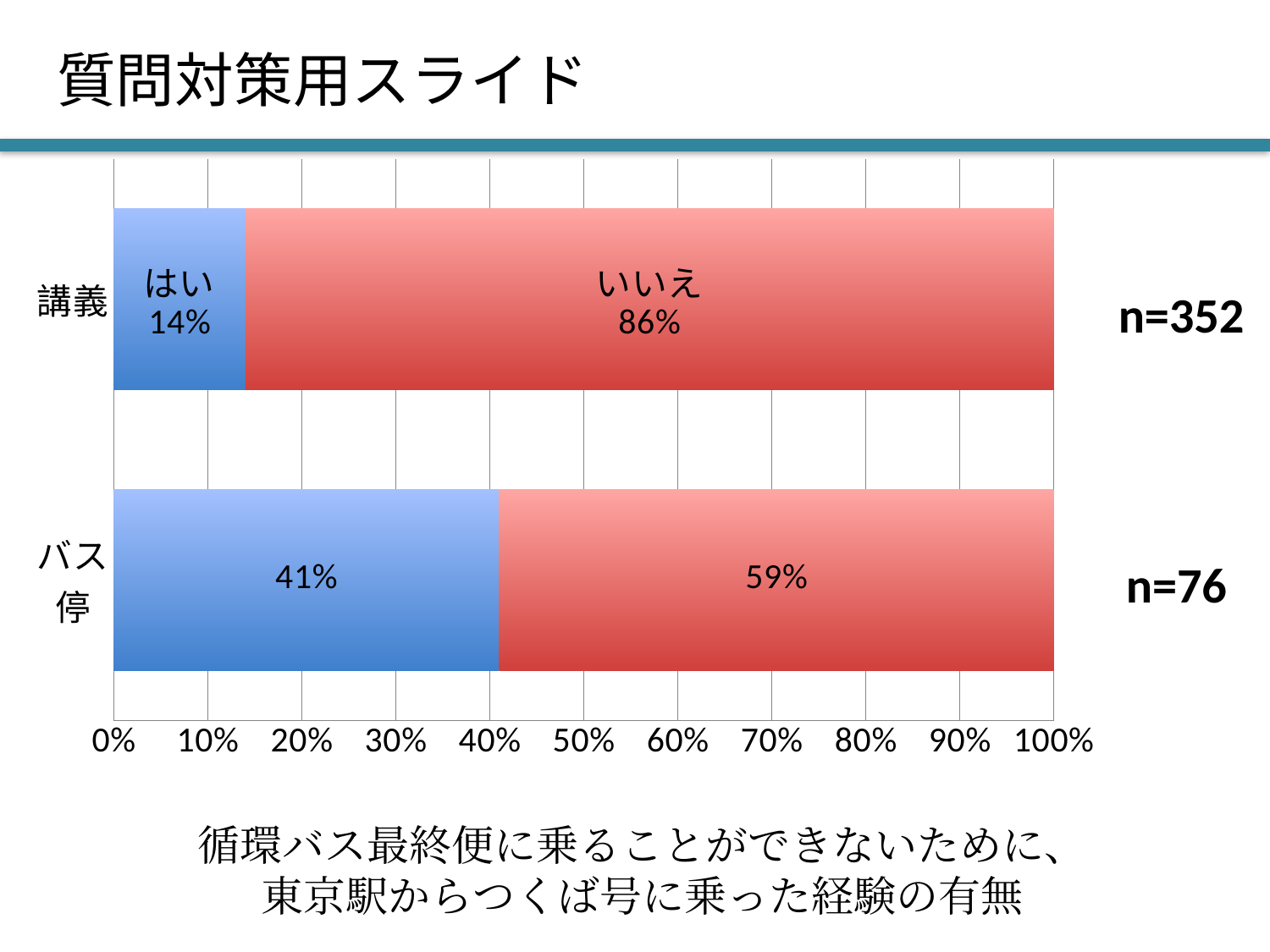
What is the difference between the いいえ percentages of 講義 and バス停? 27% What type of chart is shown on the slide? Stacked bar chart How many categories (bars) are shown in the chart? 2 What percentage of the 講義 group answered いいえ? 86% What is the はい share for the バス停 group? 41% What is the total of the two segments in the 講義 bar? 100% What is the difference between the はい percentages of バス停 and 講義? 27% What percentage of the 講義 group answered はい? 14% What is the いいえ share for the バス停 group? 59% Which group has the higher はい percentage, 講義 or バス停? バス停 What is the sample size (n) for the 講義 group? n=352 What is the sample size (n) for the バス停 group? n=76